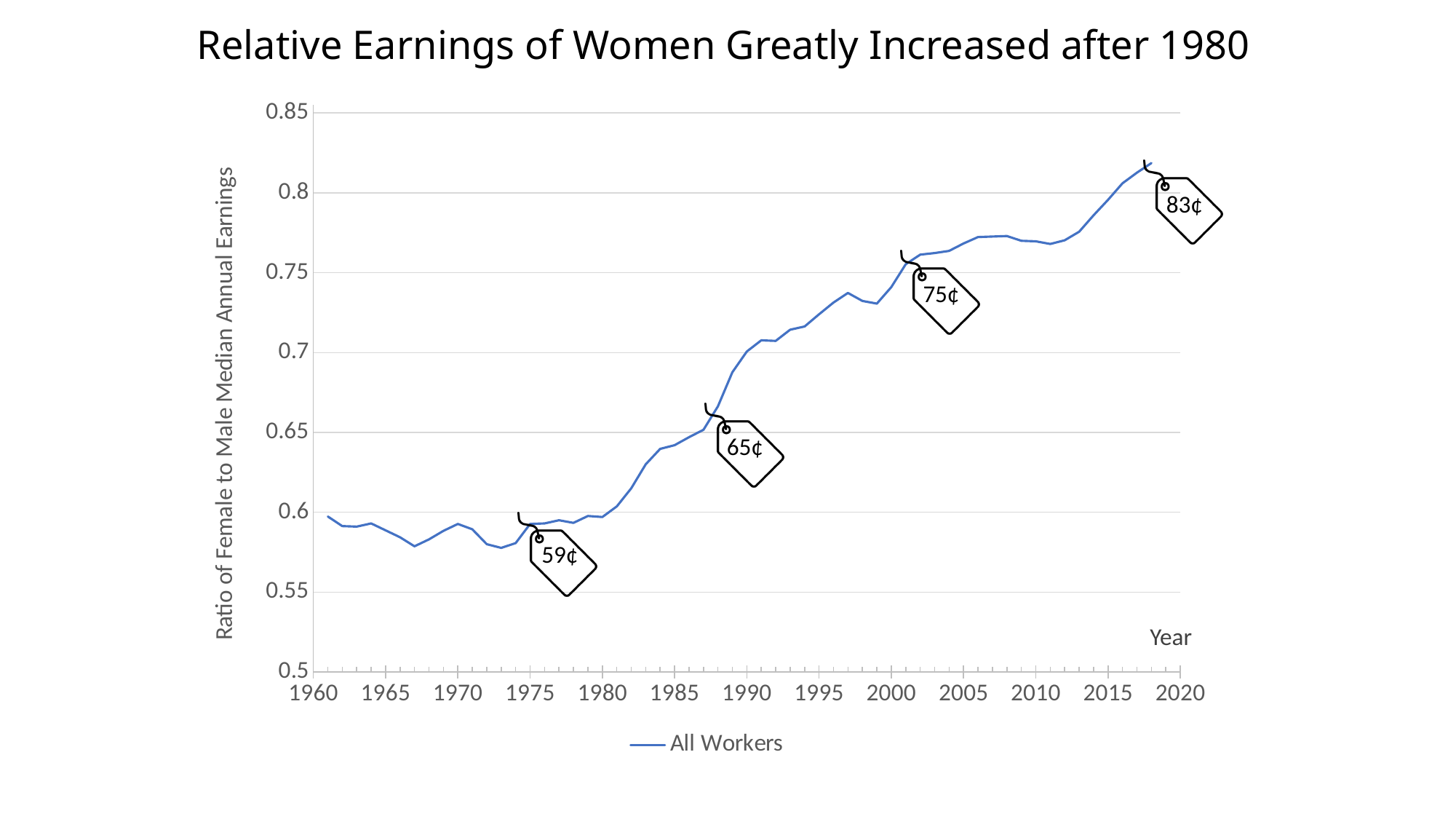
Is the value for 1995 greater or less than 0.7? greater Does the ratio of female to male earnings generally rise or fall from 1980 to 2020? rise What kind of chart is shown on the slide? line chart What is the label on the vertical axis? Ratio of Female to Male Median Annual Earnings What value is printed on the price tag attached near 2018? 83¢ What is the name of the series shown in the legend? All Workers Is the value for 2018 greater or less than 0.8? greater What value is printed on the price tag attached near 1975? 59¢ Is the value for 1967 greater or less than 0.6? less Which year has the larger value, 1975 or 2000? 2000 How many series does the legend list? 1